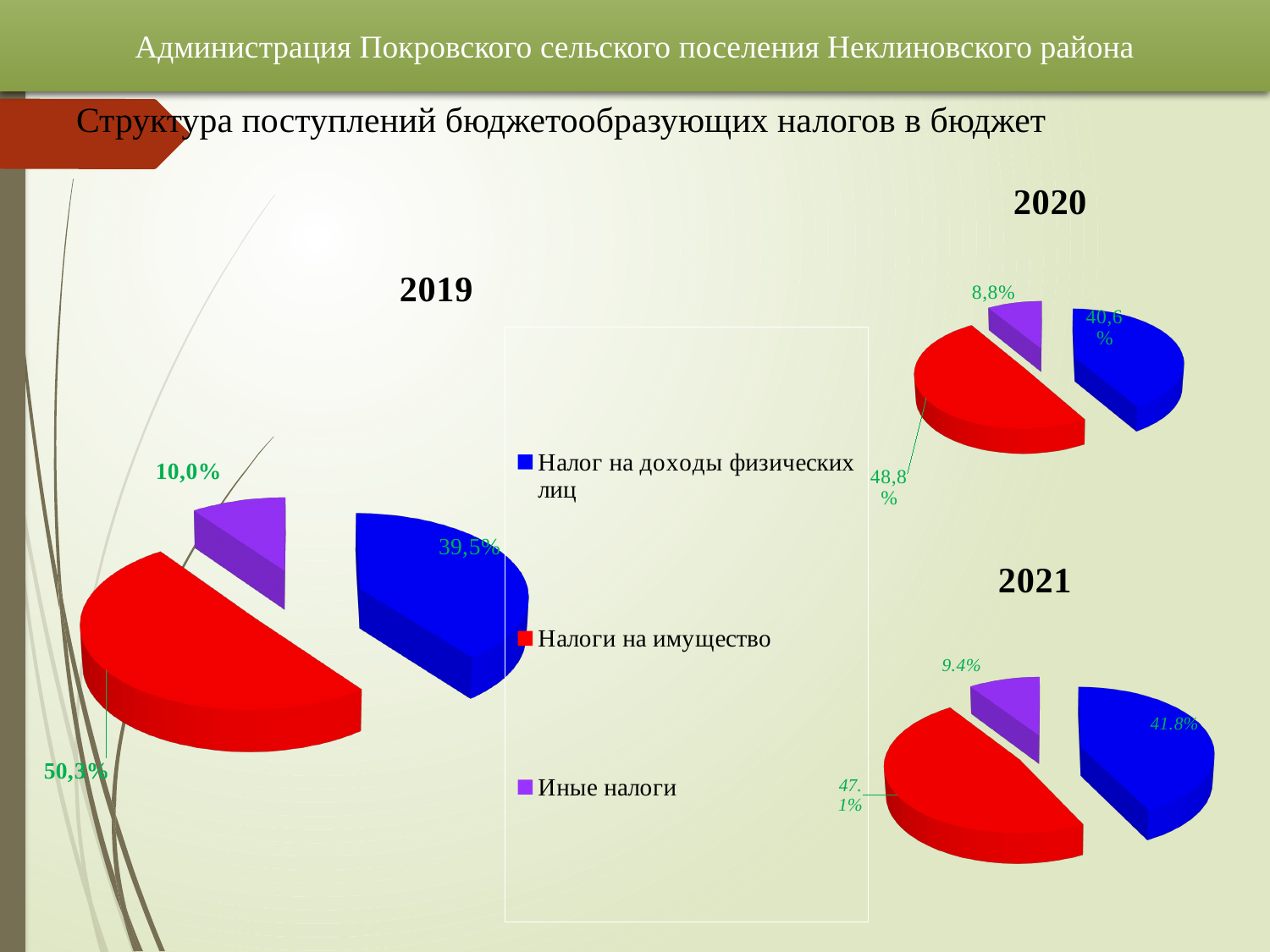
What type of chart is used for the 2019 data? Pie chart How many categories does the legend list? 3 In the 2020 pie chart, what share is shown for Налог на доходы физических лиц? 40,6% In the 2019 pie chart, what share is shown for Иные налоги? 10,0% In the 2021 pie chart, what share is shown for Налоги на имущество? 47.1% In the 2019 pie chart, what share is shown for Налоги на имущество? 50,3% In the 2019 pie chart, which category has the smallest share? Иные налоги In the 2021 pie chart, which is larger: Налог на доходы физических лиц or Налоги на имущество? Налоги на имущество How many pie charts are shown on the slide? 3 In the 2021 pie chart, what share is shown for Иные налоги? 9.4% In the 2020 pie chart, which category has the largest share? Налоги на имущество In the 2020 pie chart, what is the difference between the shares of Налоги на имущество and Налог на доходы физических лиц? 8,2%